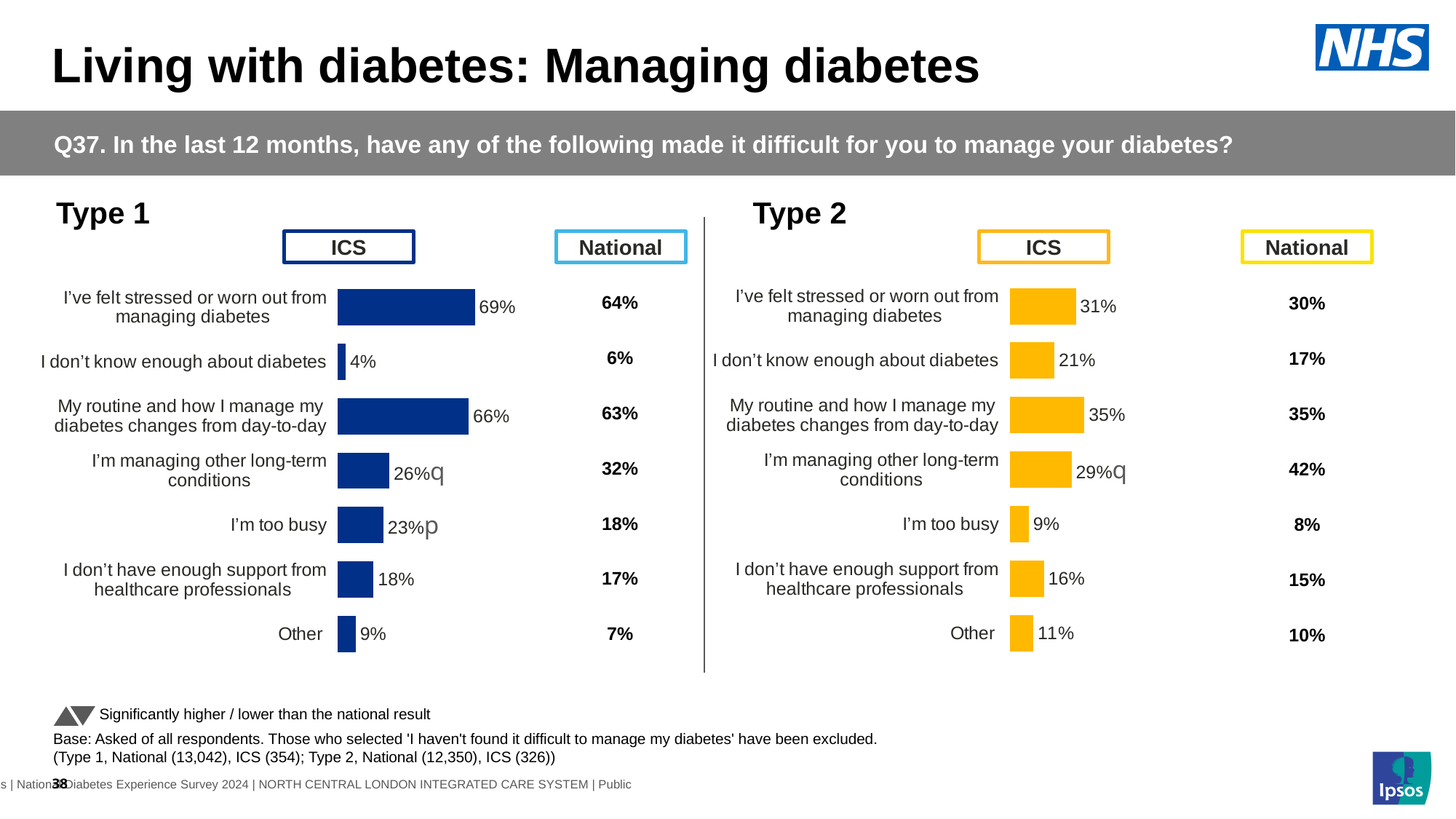
In the Type 1 chart, what is the difference between the ICS and National values for 'I'm too busy'? 5 percentage points In the Type 2 chart, what is the ICS value for 'I don't know enough about diabetes'? 21% In the Type 2 chart, which is larger for 'Other': the ICS value or the National value? ICS In the Type 1 chart, what is the National value for 'I'm managing other long-term conditions'? 32% In the Type 1 chart, which is larger for 'I don't have enough support from healthcare professionals': the ICS value or the National value? ICS What colour are the ICS bars in the Type 2 chart? Yellow/orange In the Type 1 chart, which category has the lowest ICS value? I don't know enough about diabetes In the Type 2 chart, what is the difference between the National and ICS values for 'I'm managing other long-term conditions'? 13 percentage points What type of chart is used to show the ICS values in the Type 2 chart? Bar chart In the Type 2 chart, which category has the highest ICS value? My routine and how I manage my diabetes changes from day-to-day How many categories are shown in the Type 1 chart? 7 In the Type 1 chart, what is the ICS value for 'I've felt stressed or worn out from managing diabetes'? 69%